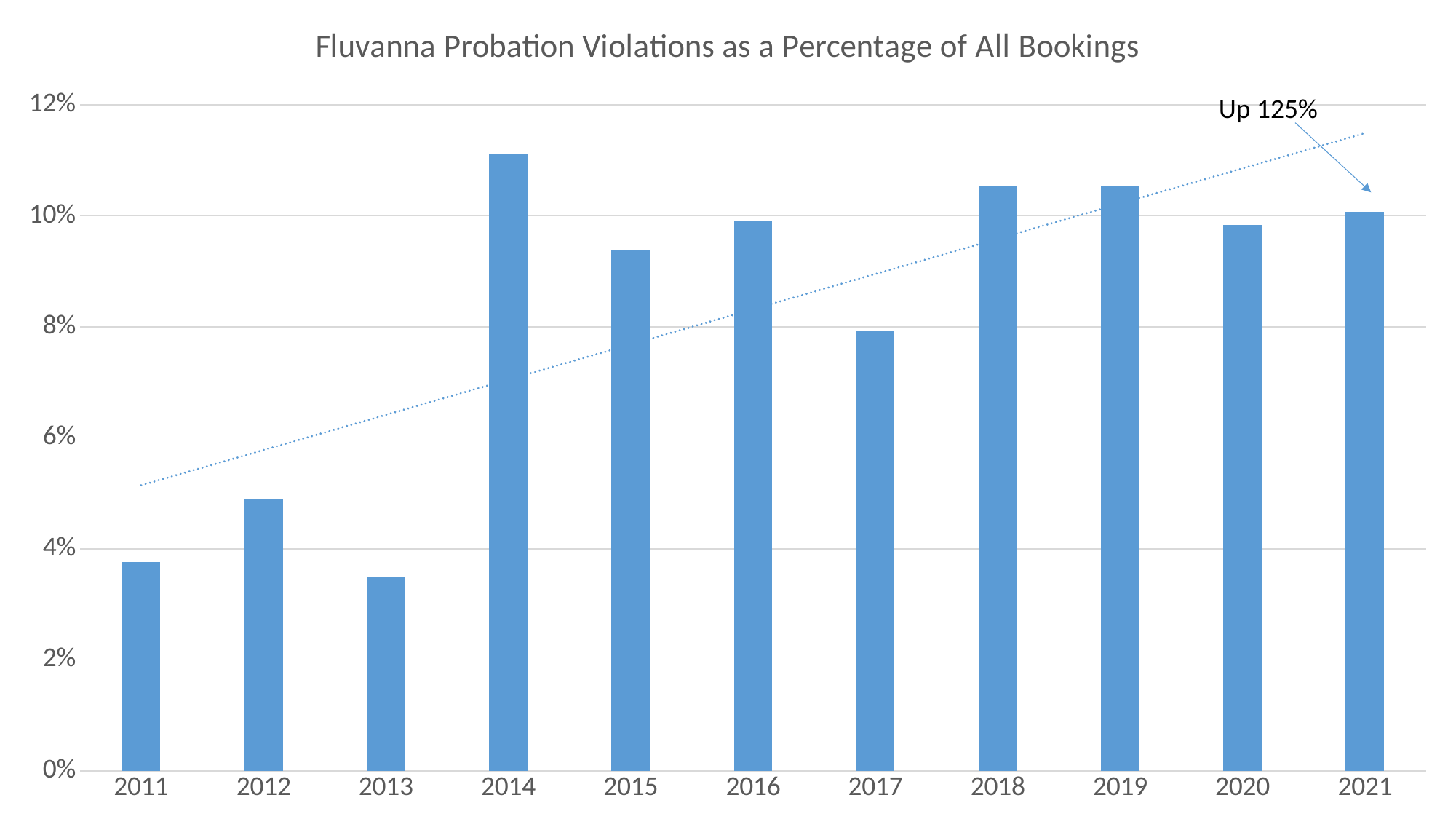
Is the value for 2013 greater or less than 4%? less Which year has the lowest probation violation percentage? 2013 Does the dotted trend line rise or fall from 2011 to 2021? Rises What does the annotation with the arrow near the 2021 bar say? Up 125% Which year has the highest probation violation percentage? 2014 Is the value for 2014 greater or less than 10%? greater What kind of chart is shown on the slide? Bar chart Is the value for 2018 greater or less than 10%? greater How many years are plotted on the x axis of the chart? 11 What is the title of the chart? Fluvanna Probation Violations as a Percentage of All Bookings Which year has a higher value, 2016 or 2017? 2016